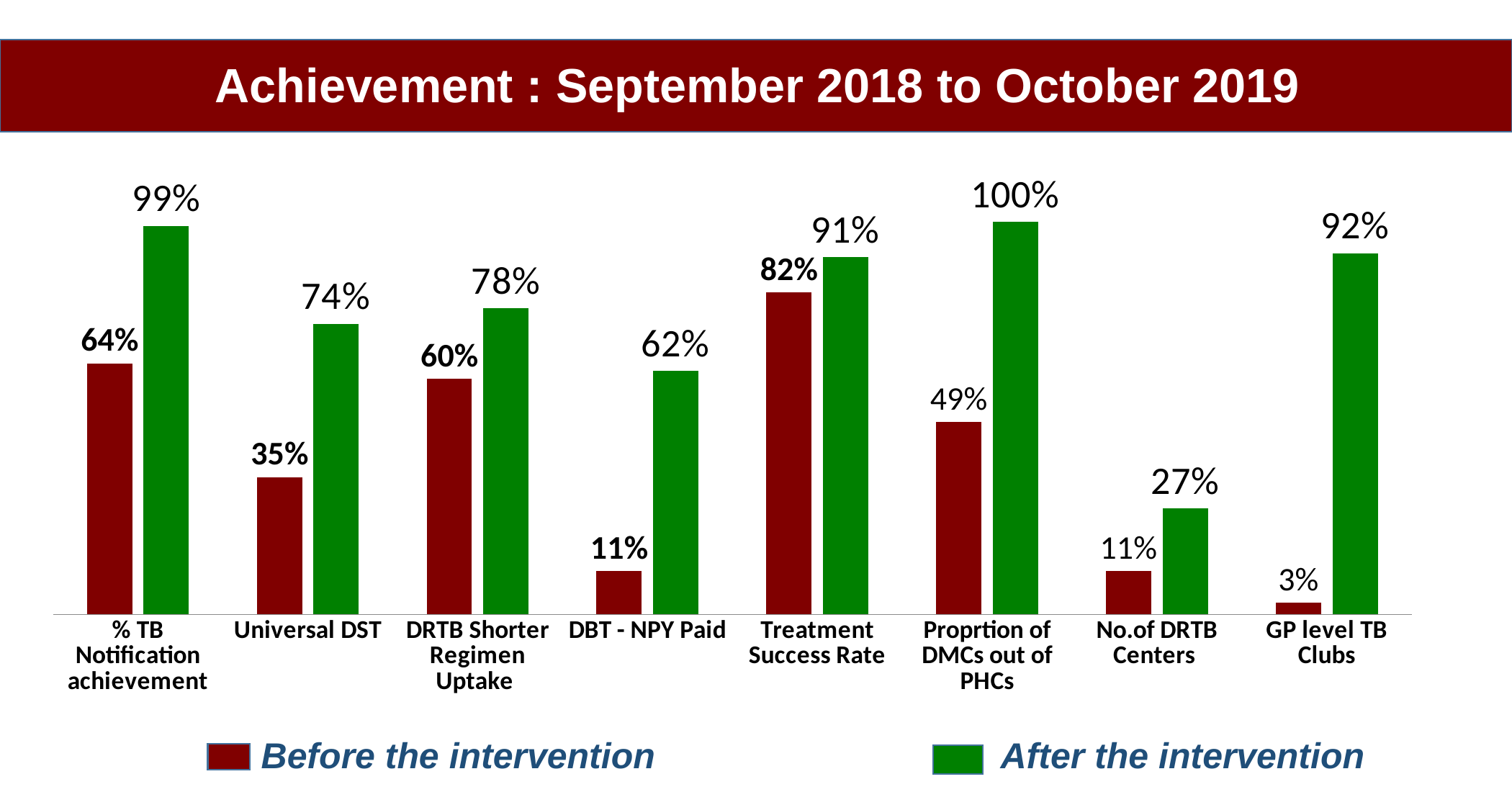
Which category has the highest value after the intervention? Proprtion of DMCs out of PHCs What is the value for GP level TB Clubs after the intervention? 92% Which is larger: the before-intervention value for Treatment Success Rate or the after-intervention value for DRTB Shorter Regimen Uptake? Before-intervention value for Treatment Success Rate Which category has the lowest value before the intervention? GP level TB Clubs What is the value for DBT - NPY Paid before the intervention? 11% What is the difference between the after and before values for DBT - NPY Paid? 51% How many categories are shown on the x axis? 8 What kind of chart is shown on the slide? Bar chart What is the value for Universal DST before the intervention? 35% What is the difference between the after and before values for Treatment Success Rate? 9% What colour represents 'After the intervention' in the legend? Green How many series does the legend list? 2